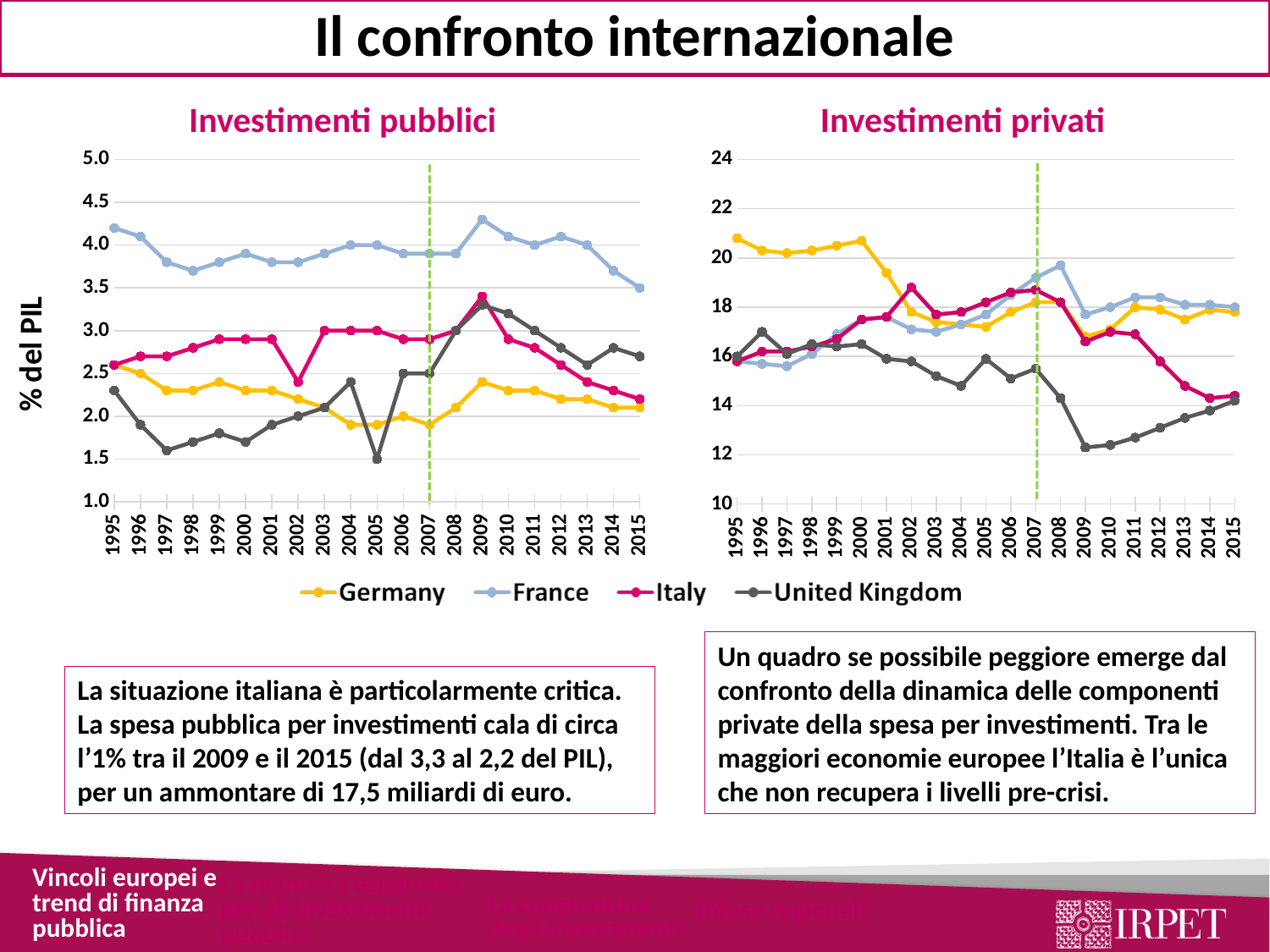
In the 'Investimenti pubblici' chart, is the value for United Kingdom in 1997 greater or less than 2.0? less In the 'Investimenti privati' chart, which country has the highest value in 2000? Germany What kind of chart is the 'Investimenti pubblici' chart? line chart In the 'Investimenti privati' chart, does the United Kingdom line rise or fall from 2007 to 2009? fall In the 'Investimenti privati' chart, which is larger in 2002, Italy or Germany? Italy In the 'Investimenti pubblici' chart, which country has the highest value in 2015? France How many years are plotted along the x axis of the 'Investimenti privati' chart? 21 How many series does the legend list for the charts? 4 In the 'Investimenti privati' chart, is the value for United Kingdom in 2009 greater or less than 14? less In the 'Investimenti privati' chart, which country has the lowest value in 2009? United Kingdom In the 'Investimenti pubblici' chart, is the value for France in 2009 greater or less than 4.0? greater What is the y-axis label shown on the left of the 'Investimenti pubblici' chart? % del PIL